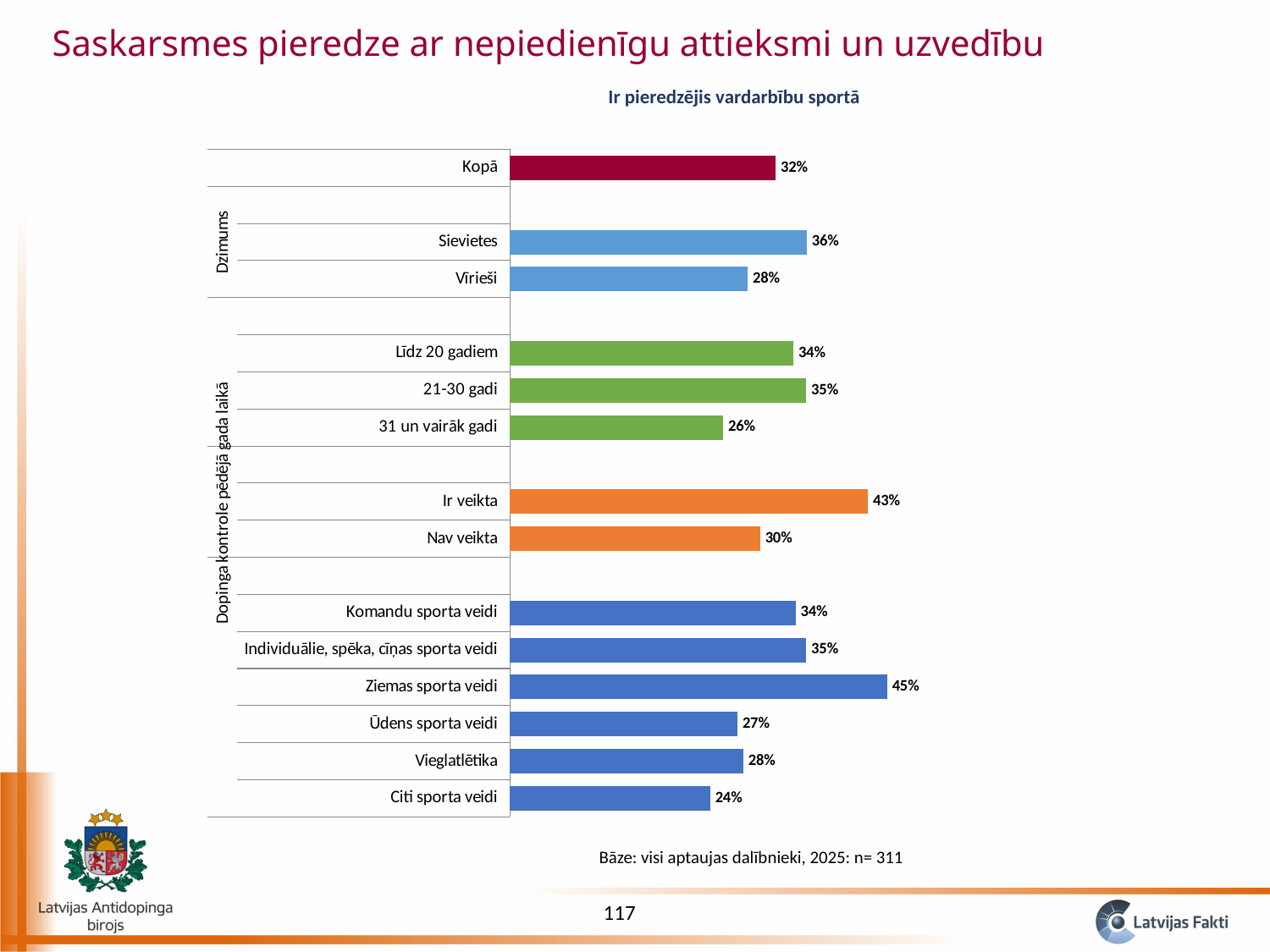
Which category has the lowest value in the chart? Citi sporta veidi What is the value for Ir veikta? 43% How many bars are plotted in the chart? 14 Which is larger, the value for Līdz 20 gadiem or the value for 31 un vairāk gadi? Līdz 20 gadiem What is the difference between the values for Sievietes and Vīrieši? 8% What is the value for 31 un vairāk gadi? 26% What is the difference between the values for Ir veikta and Nav veikta? 13% What is the title of the chart? Ir pieredzējis vardarbību sportā Which category has the highest value in the chart? Ziemas sporta veidi What is the value for Ziemas sporta veidi? 45% What kind of chart is shown on the slide? Bar chart What is the value for Kopā? 32%